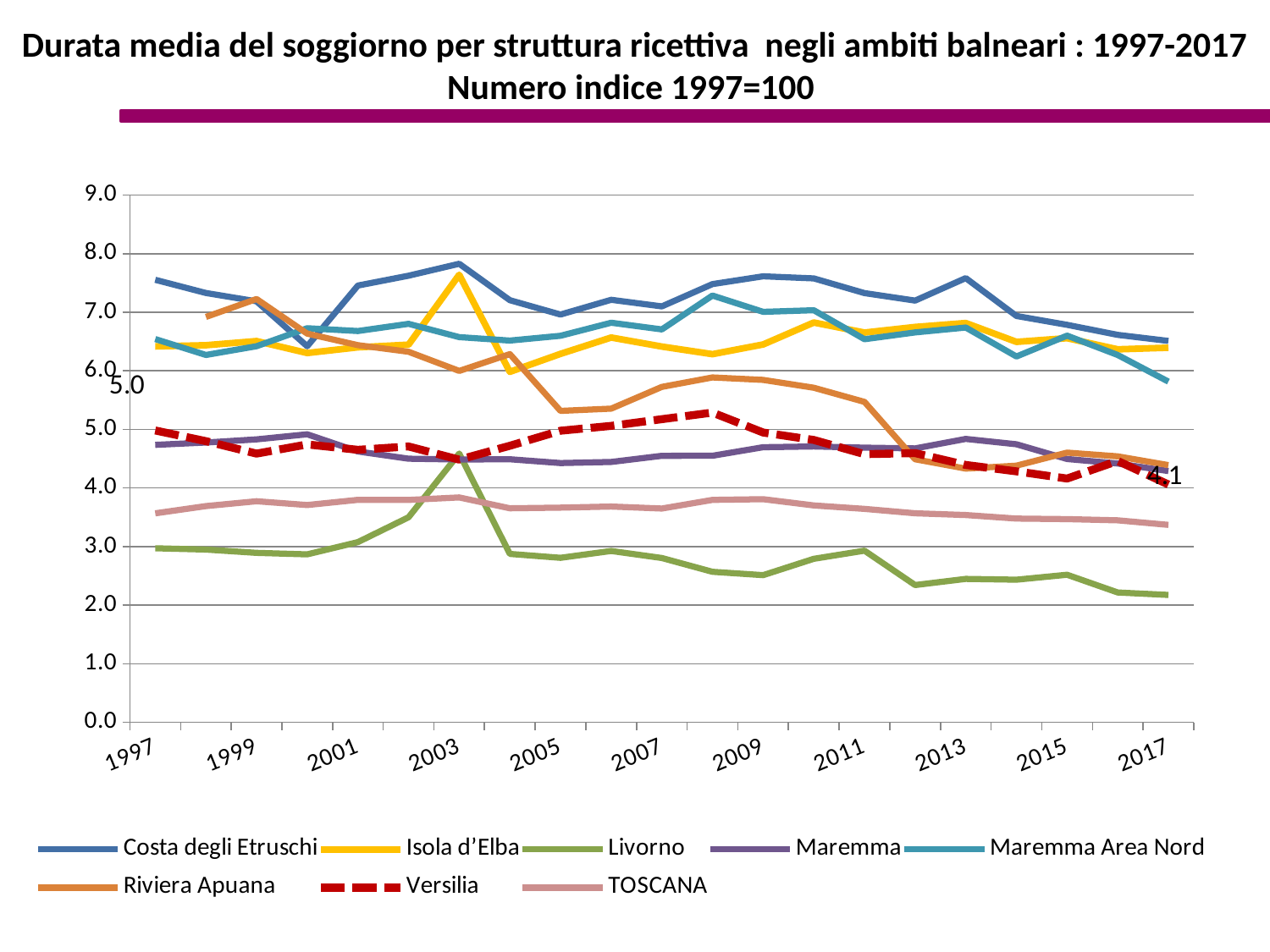
What is the value for Versilia in 1997? 5.0 Is the value for Costa degli Etruschi in 1997 greater or less than 7.0? greater Which series has the highest value in 1997? Costa degli Etruschi Which series has the lowest values across the whole period? Livorno Does the TOSCANA line rise or fall overall from 1997 to 2017? fall How many series does the legend list? 8 Is the value for Livorno in 2017 greater or less than 3.0? less By how much did the Versilia value fall between 1997 and 2017? 0.9 Which series is drawn with a dashed line? Versilia What is the value for Versilia in 2017? 4.1 What kind of chart is shown on the slide? line chart Which is larger in 2009, the value for Costa degli Etruschi or the value for Livorno? Costa degli Etruschi